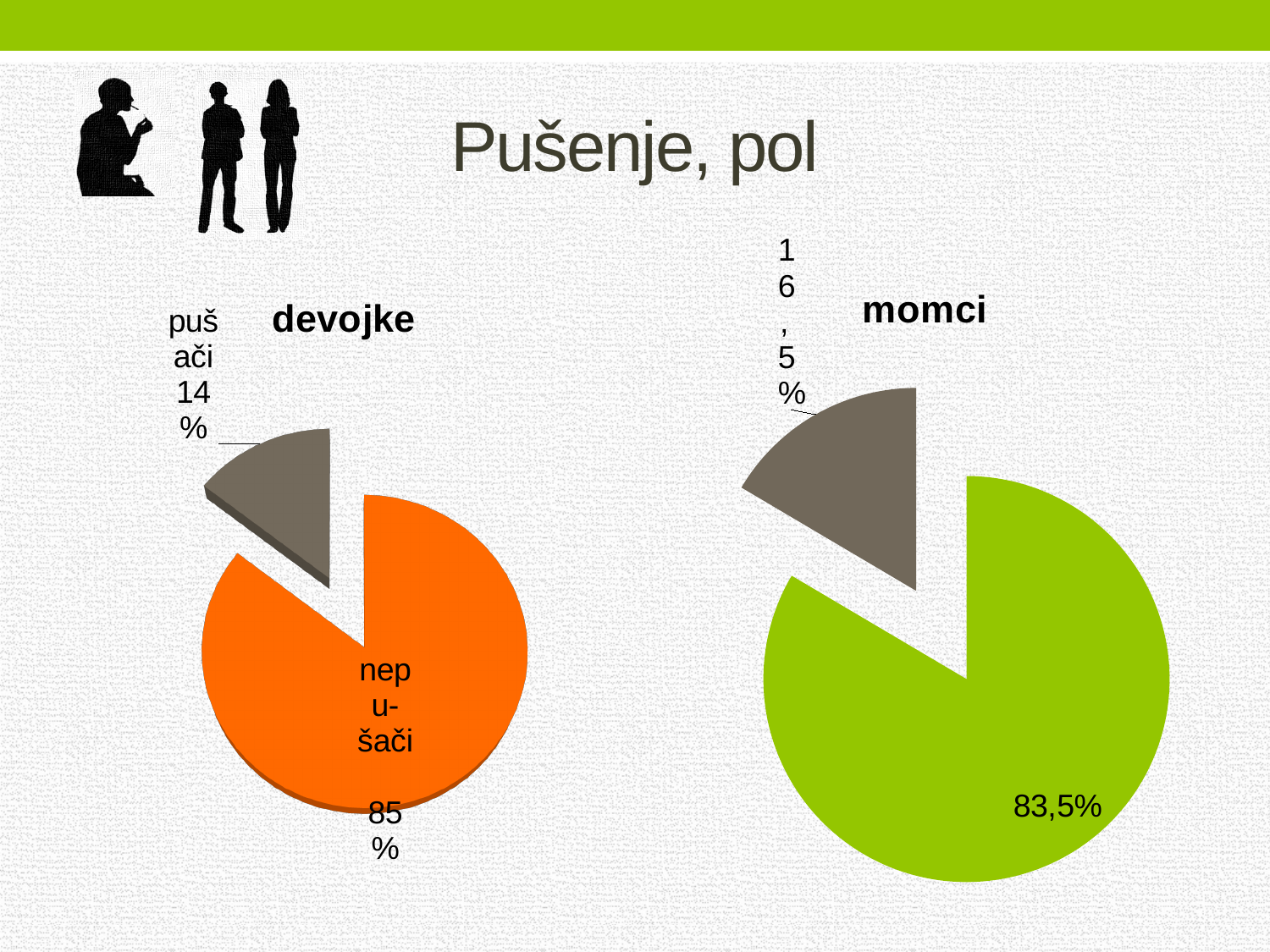
Which is larger: the pušači value in the 'devojke' chart or the small grey slice value in the 'momci' chart? The 'momci' grey slice (16,5%) What kind of charts are shown on the slide? Pie charts In the 'momci' chart, what value is shown on the small grey slice? 16,5% In the 'devojke' chart, which category has the largest slice? nepušači In the 'momci' chart, how many slices does the pie have? 2 In the 'momci' chart, what value is shown on the large green slice? 83,5% In the 'devojke' chart, what is the difference between the nepušači and pušači values? 71% In the 'devojke' chart, what is the value for nepušači? 85% What is the title of the slide containing the two pie charts? Pušenje, pol In the 'devojke' chart, which category has the smallest slice? pušači In the 'devojke' chart, how many slices does the pie have? 2 In the 'devojke' chart, what is the value for pušači? 14%